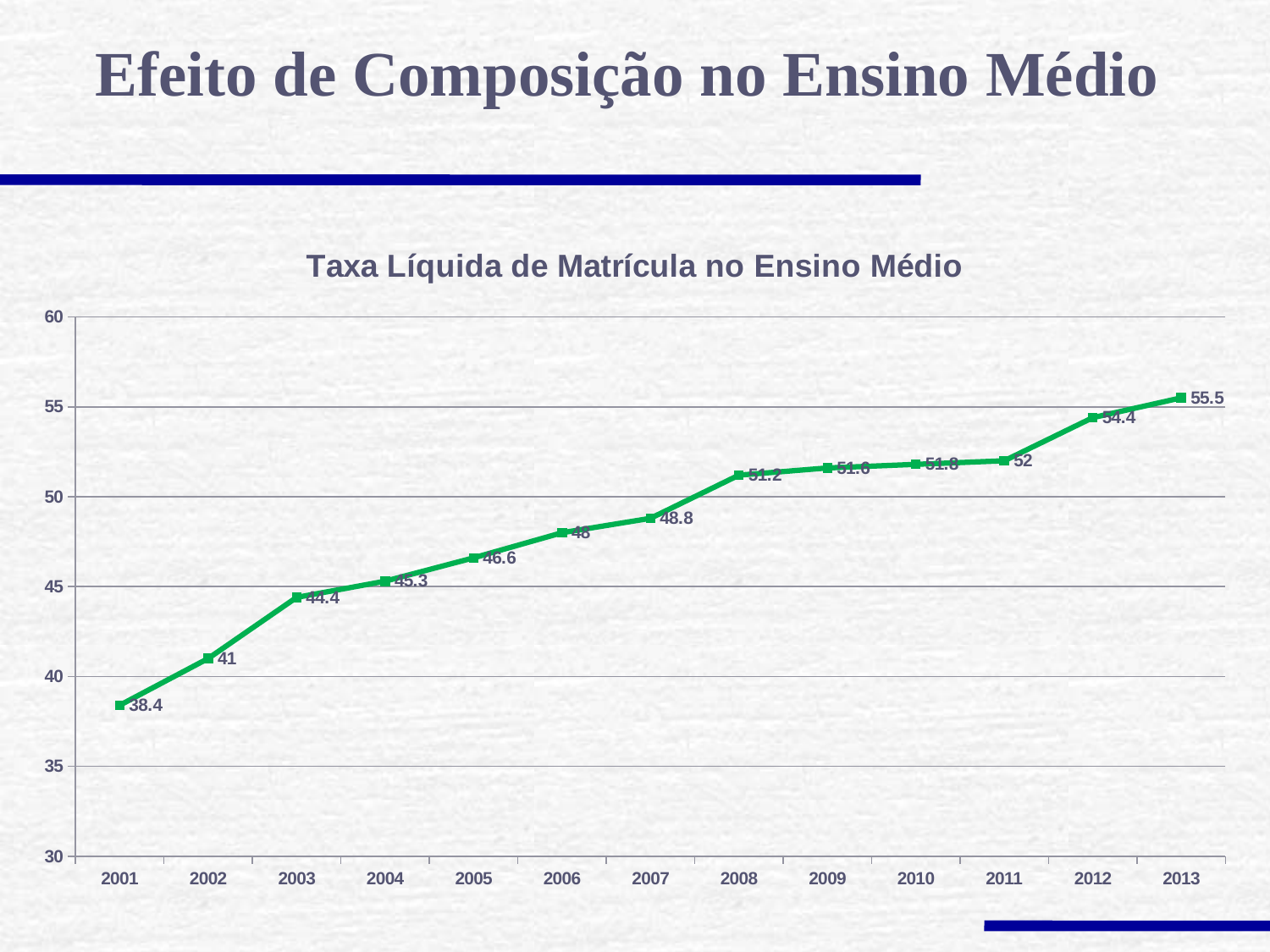
What is the difference between the values for 2008 and 2007? 2.4 What is the difference between the values for 2013 and 2001? 17.1 How many years are plotted on the chart? 13 What is the value for 2013? 55.5 What is the value for 2001? 38.4 What is the value for 2007? 48.8 What is the value for 2011? 52 Do the values rise or fall from 2001 to 2013? rise Which is larger, the value for 2004 or the value for 2006? 2006 Which year has the lowest value? 2001 What kind of chart is this? line chart Which year has the highest value? 2013